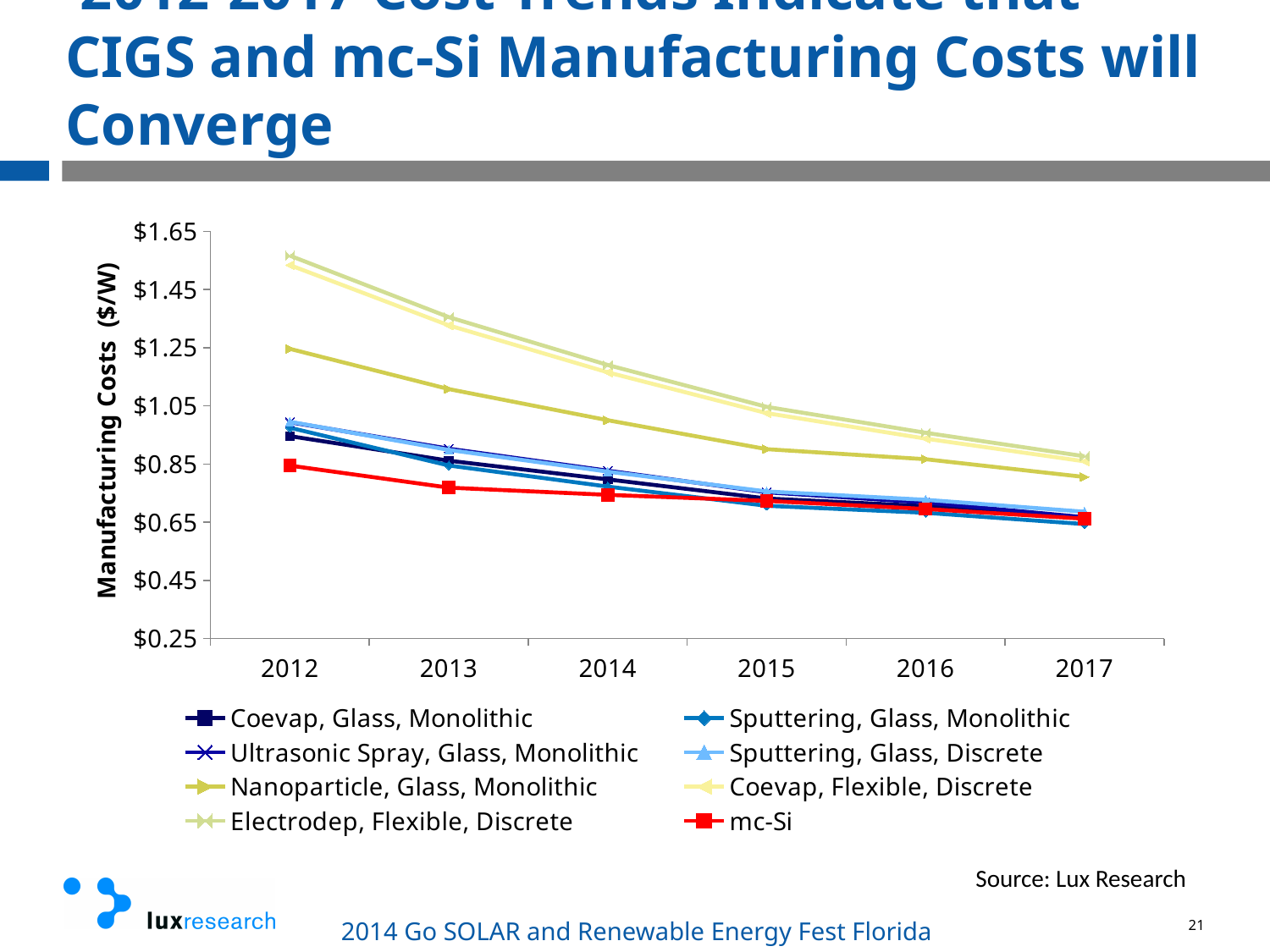
Is the 2012 value for Nanoparticle, Glass, Monolithic greater or less than $1.05? greater How many series does the legend list? 8 Do the manufacturing costs for mc-Si rise or fall from 2012 to 2017? Fall How many years are shown along the x axis? 6 What kind of chart is shown on the slide? Line chart What is the label on the y axis? Manufacturing Costs ($/W) Is the 2016 value for Electrodep, Flexible, Discrete greater or less than $1.05? less Which series has the highest manufacturing cost in 2012? Electrodep, Flexible, Discrete Which series has the lowest manufacturing cost in 2012? mc-Si Is the 2012 value for mc-Si greater or less than $1.05? less In 2014, which is larger: Electrodep, Flexible, Discrete or Nanoparticle, Glass, Monolithic? Electrodep, Flexible, Discrete